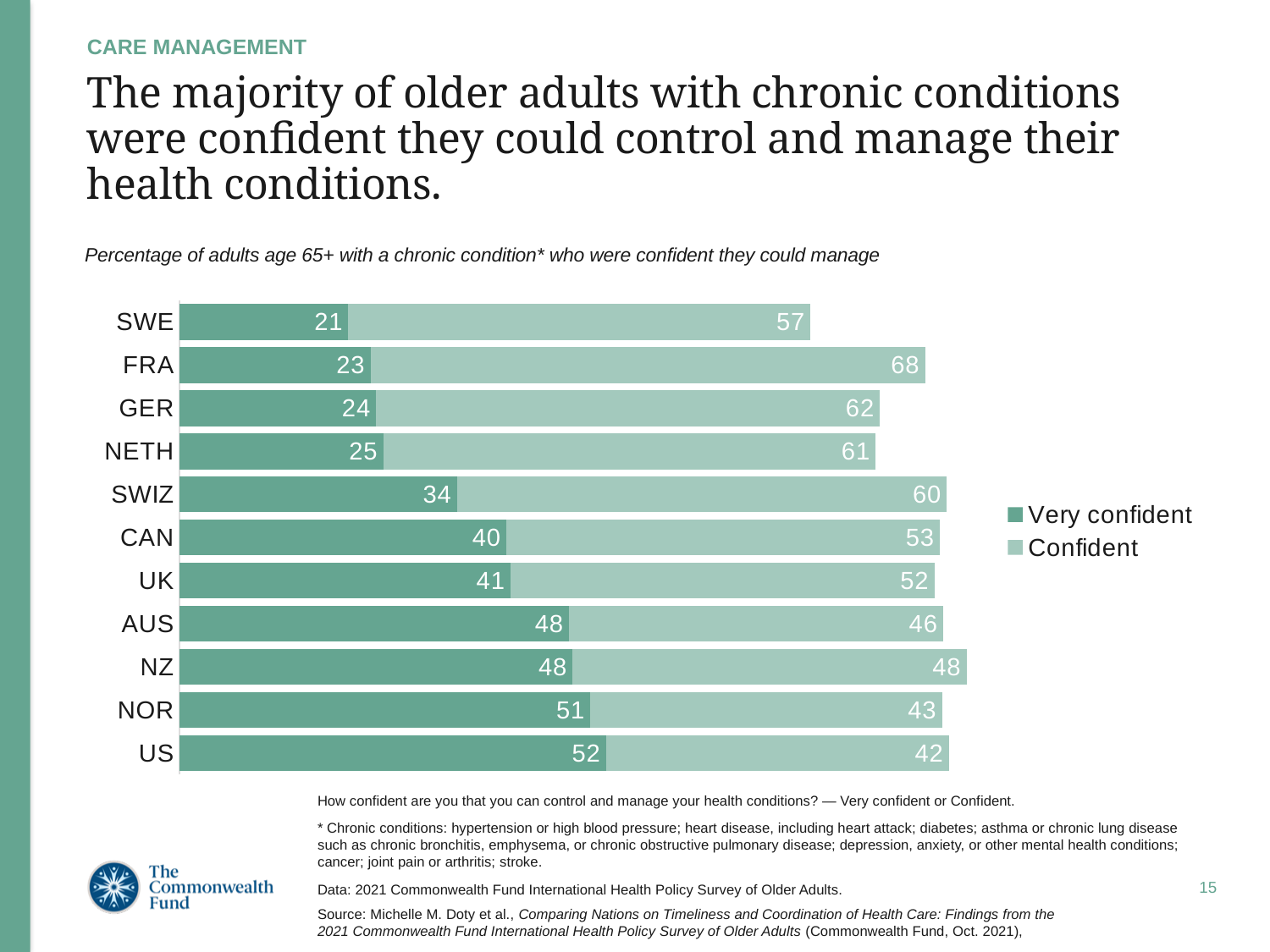
How many series does the legend list? 2 What is the combined total of 'Very confident' and 'Confident' for New Zealand? 96 What kind of chart is shown on the slide? Stacked bar chart What percentage of older adults in Canada were very confident they could manage their health conditions? 40 Which country has the highest 'Very confident' value? US What is the difference between the 'Very confident' values for the US and Sweden? 31 What is the combined total of 'Very confident' and 'Confident' for Sweden? 78 How many countries are shown in the chart? 11 Which is larger, the 'Very confident' value for Switzerland or for the Netherlands? Switzerland Which country has the lowest 'Very confident' value? SWE Which country has the highest 'Confident' value? FRA What is the 'Confident' value for France? 68